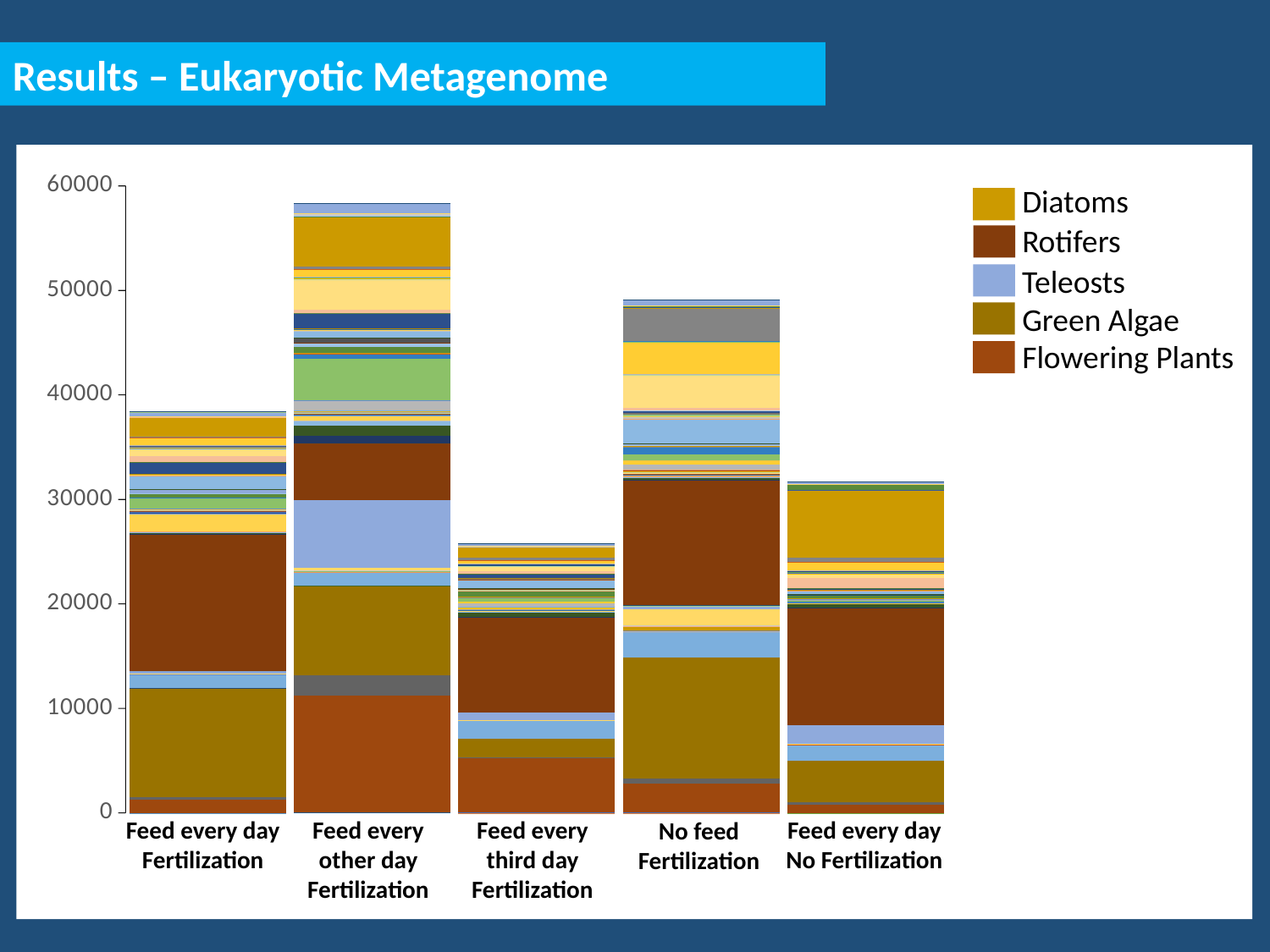
Which series is listed first in the chart legend? Diatoms Is the total stacked bar for No feed Fertilization greater or less than 40000? greater How many series does the chart legend list? 5 Which stacked bar is taller: Feed every day Fertilization or Feed every third day Fertilization? Feed every day Fertilization Is the total stacked bar for Feed every other day Fertilization greater or less than 50000? greater Which category has the tallest stacked bar? Feed every other day Fertilization How many categories are shown along the x axis of the chart? 5 What kind of chart is shown on the slide? Stacked bar chart Which category has the shortest stacked bar? Feed every third day Fertilization Which stacked bar is taller: No feed Fertilization or Feed every day No Fertilization? No feed Fertilization Is the total stacked bar for Feed every third day Fertilization greater or less than 30000? less What is the title of the slide containing the chart? Results – Eukaryotic Metagenome